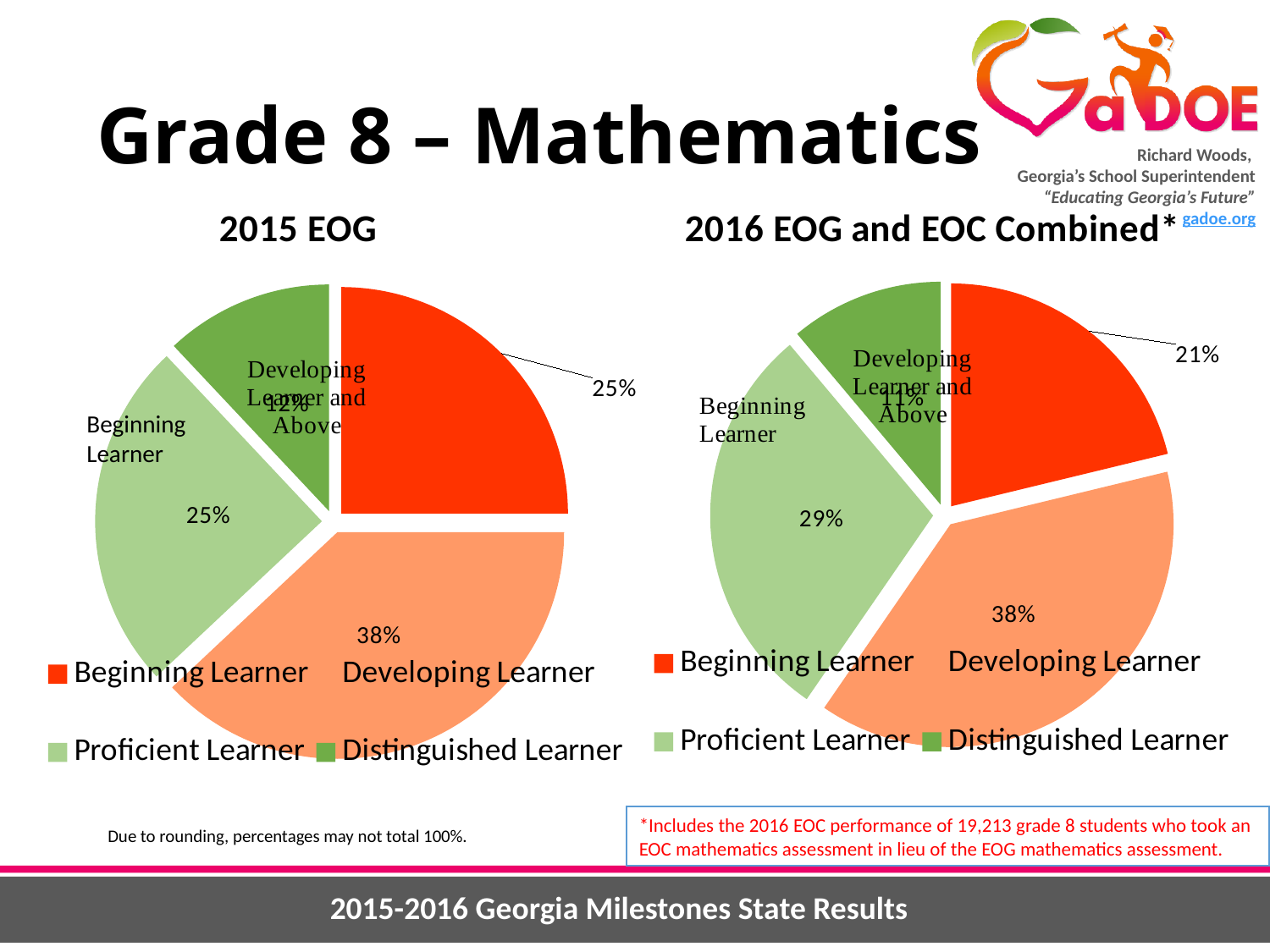
How many achievement levels are shown in the 2015 EOG chart? 4 In the 2016 EOG and EOC Combined chart, what percentage of students were Beginning Learners? 21% In the 2016 EOG and EOC Combined chart, what percentage of students were Proficient Learners? 29% In the 2016 EOG and EOC Combined chart, which colour represents Beginning Learner in the legend? Red Which chart shows a larger Proficient Learner share, 2015 EOG or 2016 EOG and EOC Combined? 2016 EOG and EOC Combined What type of chart is used for the 2016 EOG and EOC Combined data? Pie chart In the 2015 EOG chart, what is the difference between the Beginning Learner and Distinguished Learner percentages? 13% In the 2015 EOG chart, what percentage of students were Distinguished Learners? 12% In the 2016 EOG and EOC Combined chart, which achievement level has the largest share? Developing Learner In the 2015 EOG chart, which achievement level has the smallest share? Distinguished Learner In the 2015 EOG chart, what percentage of students were Developing Learners? 38% In the 2016 EOG and EOC Combined chart, what is the difference between the Developing Learner and Beginning Learner percentages? 17%